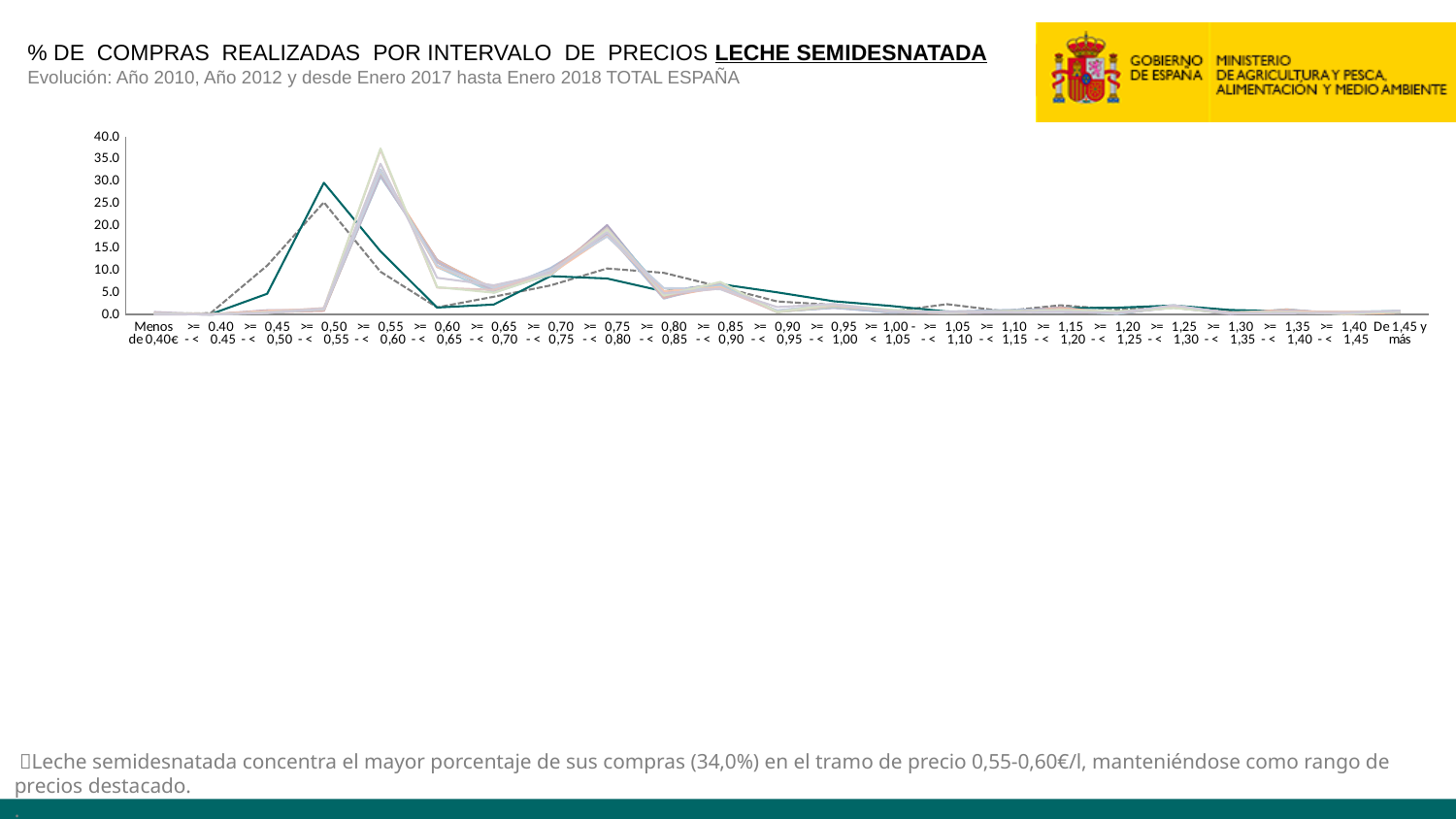
What kind of chart is shown on the slide? line chart Is the peak value of the light yellow line, at the >= 0,55 - < 0,60 interval, greater or less than 30.0? greater What is the highest value shown on the y axis of the chart? 40.0 Is the value of the dark green solid line at the 'Menos de 0,40€' interval greater or less than 5.0? less Is the value of the grey dashed line at the >= 0,75 - < 0,80 interval greater or less than 15.0? less Which product does the chart title say the purchase percentages refer to? LECHE SEMIDESNATADA Do the values of the dark green solid line rise or fall from the >= 0,50 - < 0,55 interval to the >= 0,60 - < 0,65 interval? fall According to the text on the slide, what percentage of semi-skimmed milk purchases falls in the 0,55-0,60€/l price range? 34,0% How many price intervals are shown along the x axis of the chart? 23